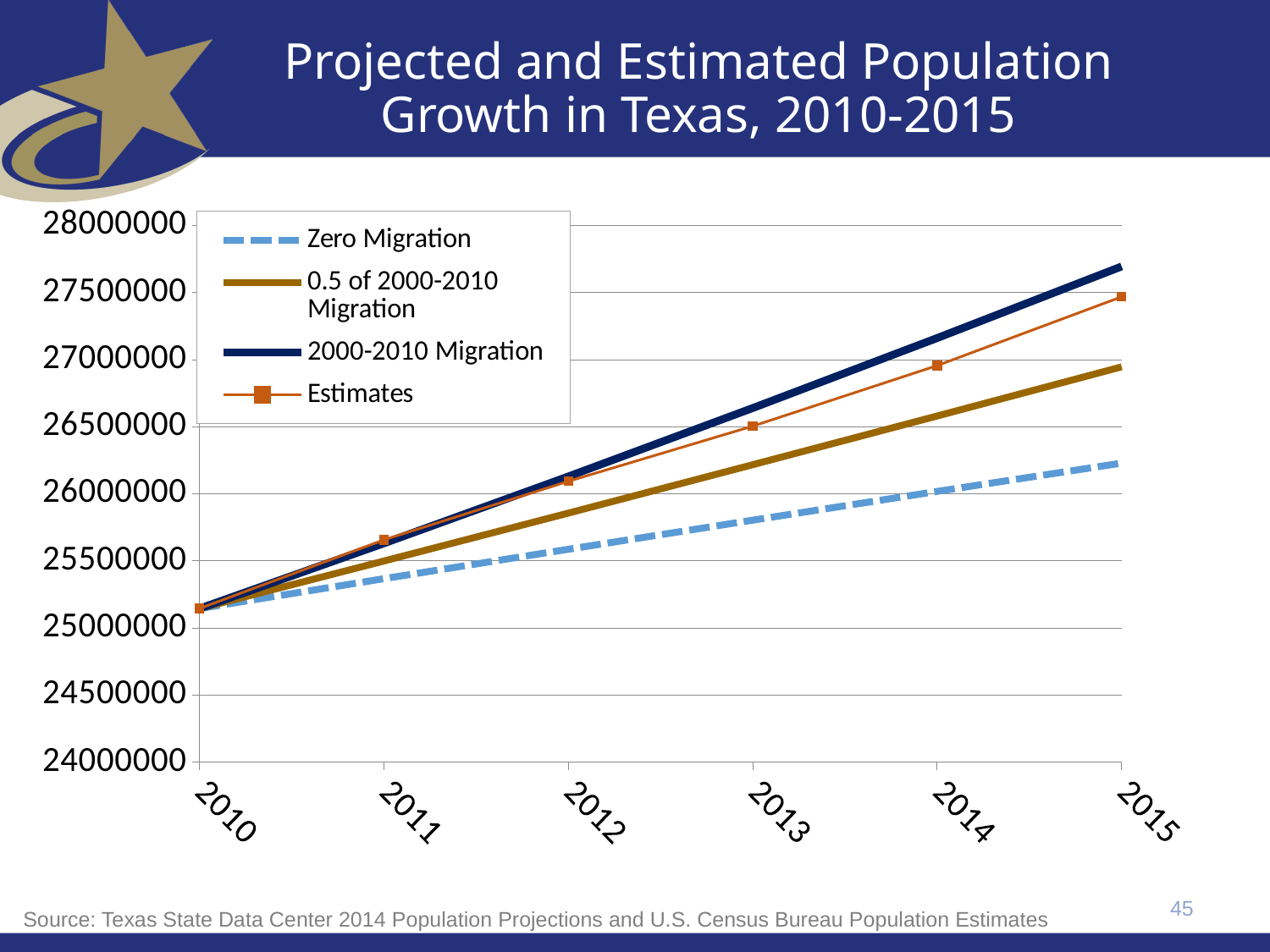
Which series is drawn with a dashed line? Zero Migration How many series does the legend list? 4 Which series has the lowest value in 2015? Zero Migration Do the values for the Zero Migration series rise or fall from 2010 to 2015? rise How many years are shown along the x axis? 6 Is the 2015 value for Zero Migration greater or less than 26500000? less Is the 2011 value for Estimates greater or less than 25500000? greater Is the 2015 value for 2000-2010 Migration greater or less than 27500000? greater In 2015, which is larger: the Estimates value or the 0.5 of 2000-2010 Migration value? Estimates Which series has the highest value in 2015? 2000-2010 Migration What kind of chart is shown on the slide? line chart